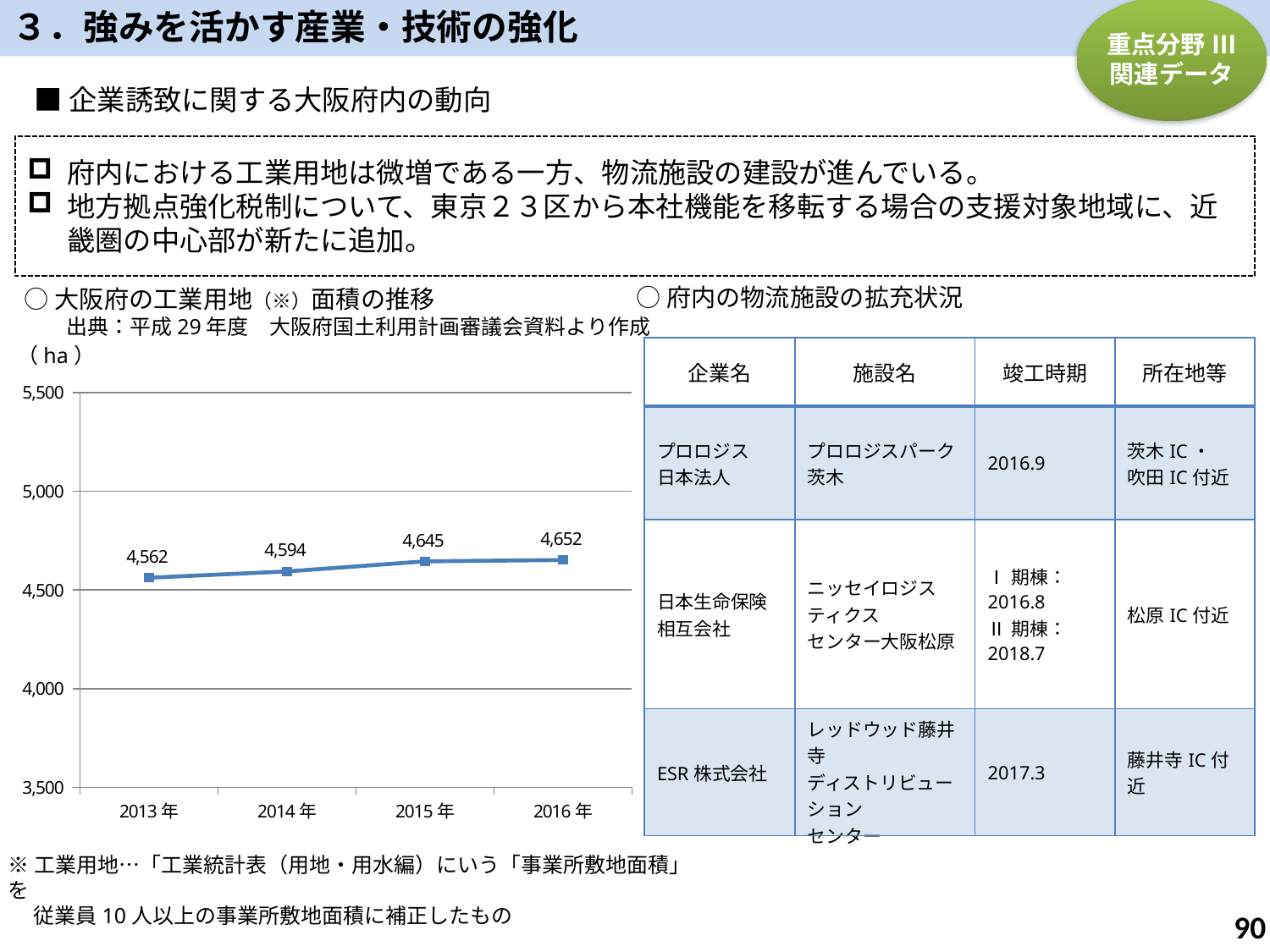
Which year has the highest value in the line chart? 2016年 What is the industrial land area (ha) for 2016年 in the line chart? 4,652 What is the value for 2015年 in the line chart? 4,645 Do the values in the line chart rise or fall from 2013年 to 2016年? rise Which year has the lowest value in the line chart? 2013年 What is the difference between the 2016年 and 2013年 values in the line chart? 90 Is the value for 2014年 in the line chart greater or less than 5,000? less What is the difference between the 2015年 and 2014年 values in the line chart? 51 What kind of chart shows the industrial land area trend? line chart Which is larger in the line chart, the value for 2014年 or 2015年? 2015年 How many years are plotted in the line chart? 4 What is the industrial land area (ha) for 2013年 in the line chart? 4,562